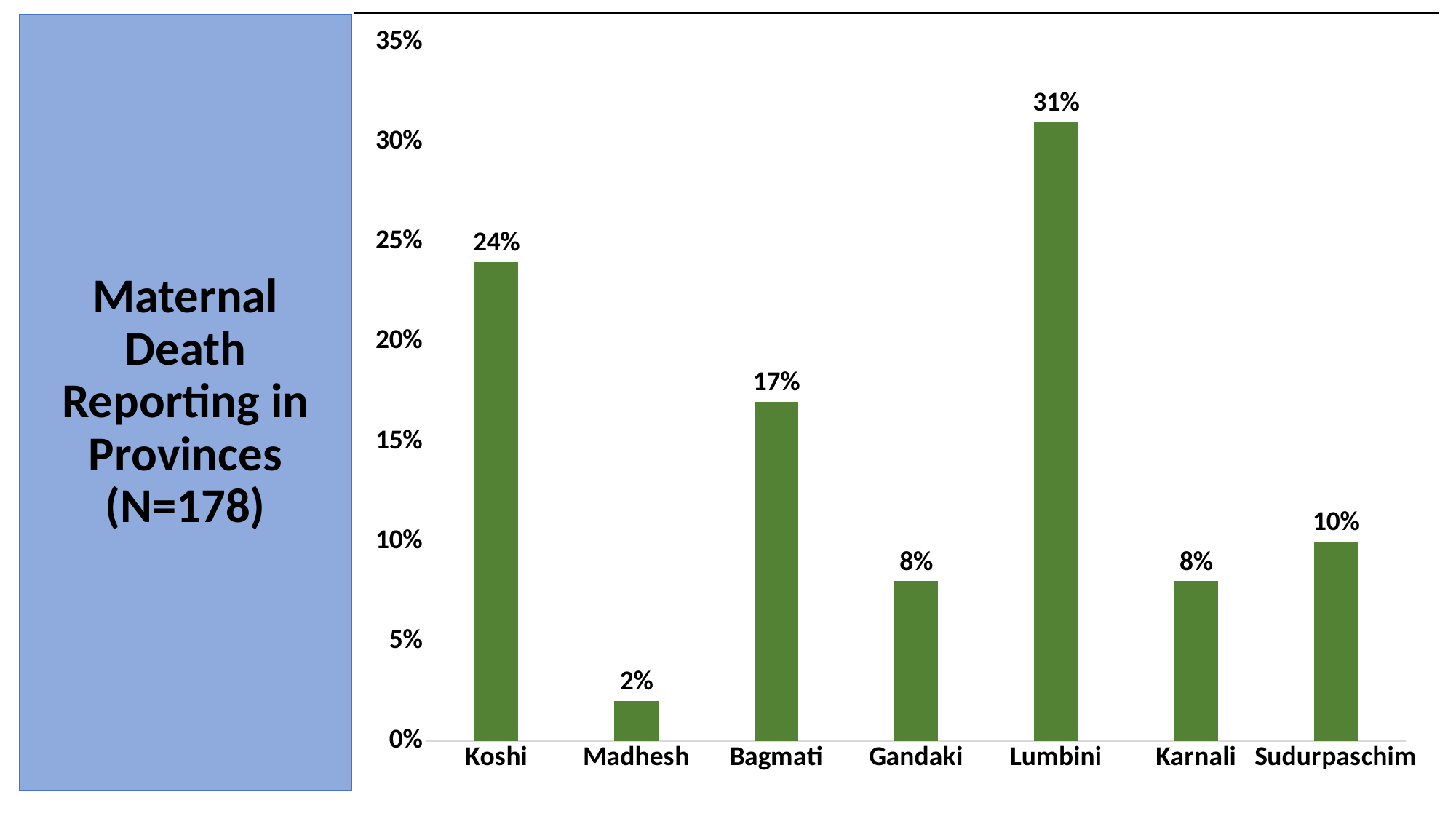
Which is larger, the value for Koshi or the value for Bagmati? Koshi Which province has the highest value? Lumbini Is the value for Koshi greater or less than 20%? greater What kind of chart is shown on the slide? bar chart How many provinces are shown on the x axis? 7 What is the value for Bagmati? 17% Which province has the lowest value? Madhesh What is the N value given in the slide title? 178 What is the difference between the values for Sudurpaschim and Gandaki? 2% What is the value for Madhesh? 2% What is the value for Lumbini? 31% What is the difference between the values for Lumbini and Koshi? 7%